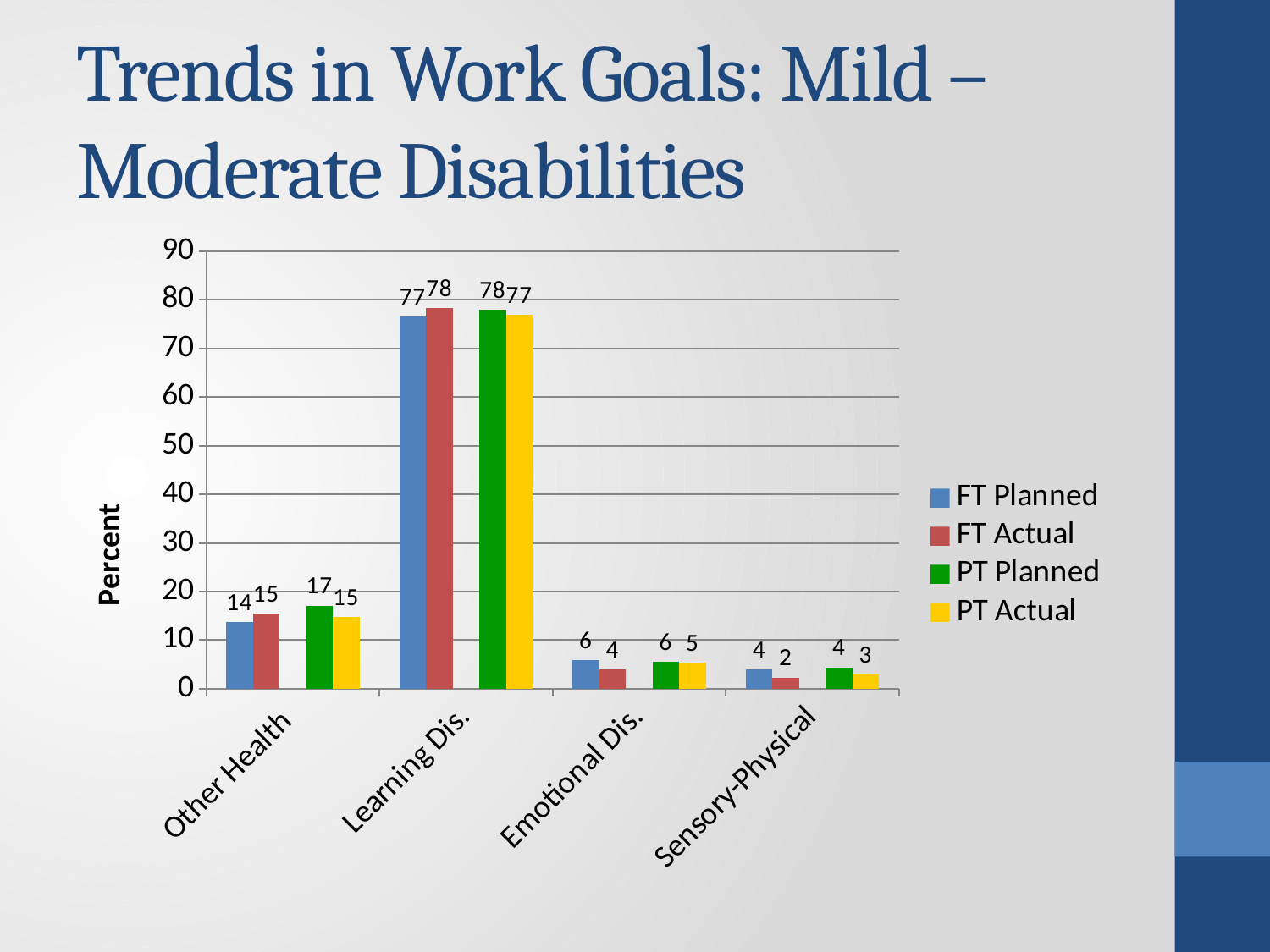
How many categories are shown on the x axis? 4 How many series does the legend list? 4 What kind of chart is shown on the slide? Bar chart What is the FT Actual value for Sensory-Physical? 2 Which category has the highest FT Actual value? Learning Dis. What is the FT Planned value for Learning Dis.? 77 What is the label of the vertical axis? Percent Which is larger for Emotional Dis., FT Planned or FT Actual? FT Planned What is the PT Planned value for Emotional Dis.? 6 What is the difference between the PT Planned and FT Planned values for Other Health? 3 What is the PT Actual value for Other Health? 15 Which category has the lowest PT Actual value? Sensory-Physical